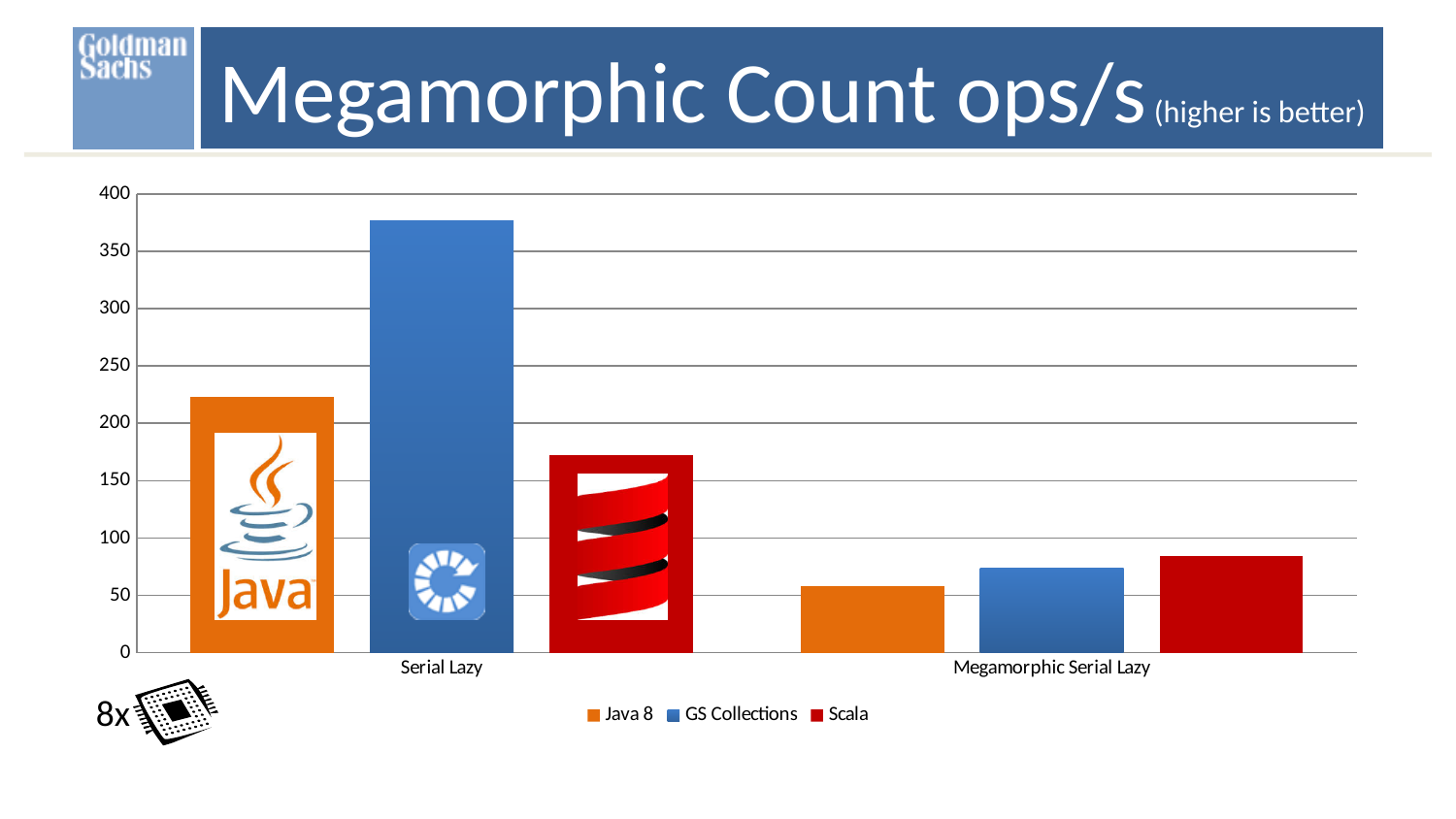
What kind of chart is shown on the slide? bar chart Is the value for GS Collections in Serial Lazy greater or less than 350? greater Which series has the highest value for Serial Lazy? GS Collections Which is larger: the Java 8 value for Serial Lazy or the Java 8 value for Megamorphic Serial Lazy? Serial Lazy Which series has the lowest value for Megamorphic Serial Lazy? Java 8 What is the title of the chart? Megamorphic Count ops/s (higher is better) Do the GS Collections values rise or fall from Serial Lazy to Megamorphic Serial Lazy? fall How many categories are shown on the x axis? 2 How many series does the legend list? 3 Which series has the lowest value for Serial Lazy? Scala Is the value for Scala in Megamorphic Serial Lazy greater or less than 100? less Is the value for Java 8 in Serial Lazy greater or less than 200? greater